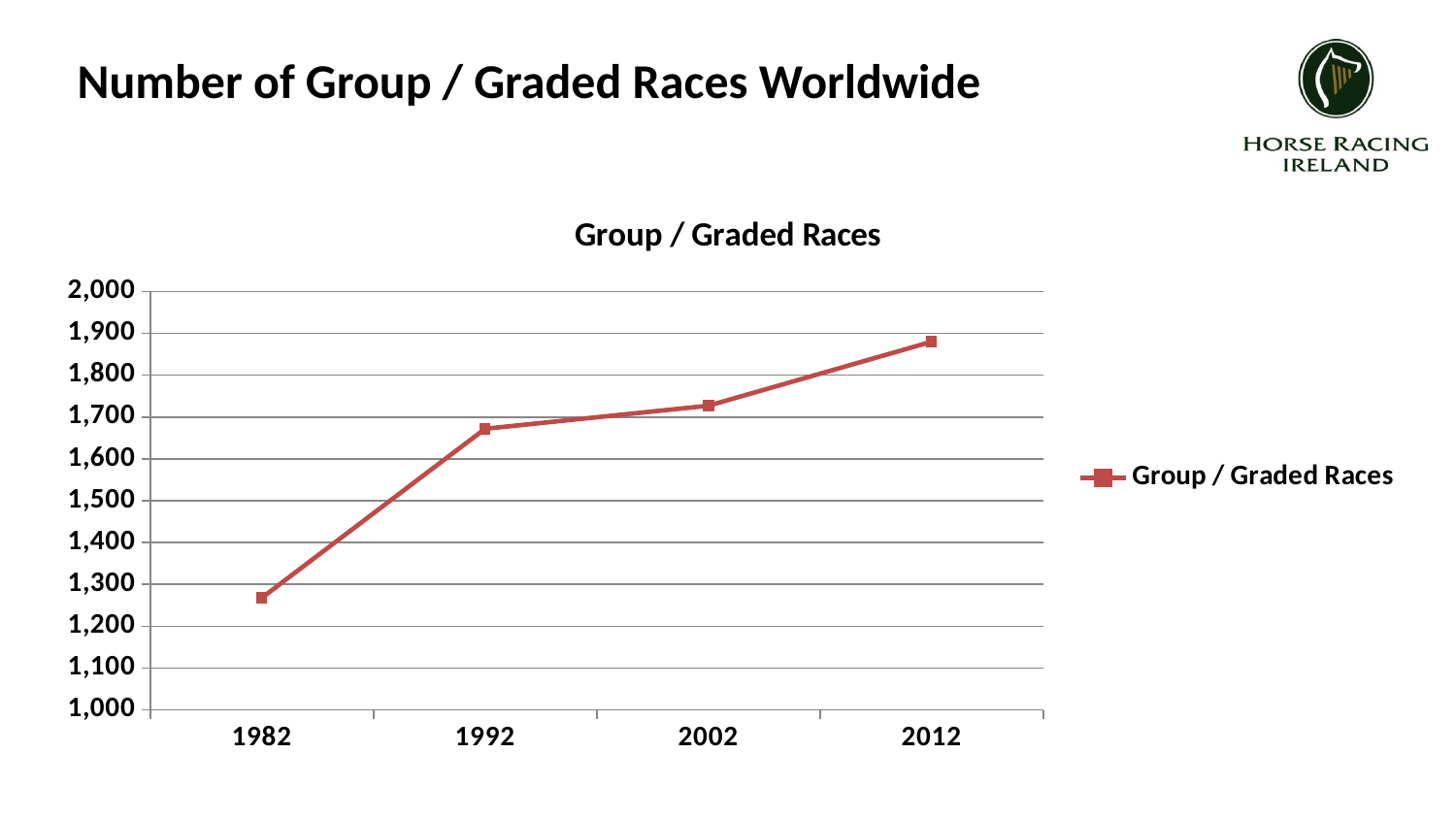
Which year has the lowest number of Group / Graded Races? 1982 Is the value for 1982 greater or less than 1,300? less How many series does the legend list? 1 Is the value for 2012 greater or less than 1,800? greater What kind of chart is shown on the slide? line chart Is the value for 2002 greater or less than 1,700? greater How many years are plotted on the x axis? 4 Which year has the highest number of Group / Graded Races? 2012 Do the values rise or fall from 1982 to 2012? rise What is the title of the chart? Group / Graded Races Which is larger, the value for 1992 or the value for 2012? 2012